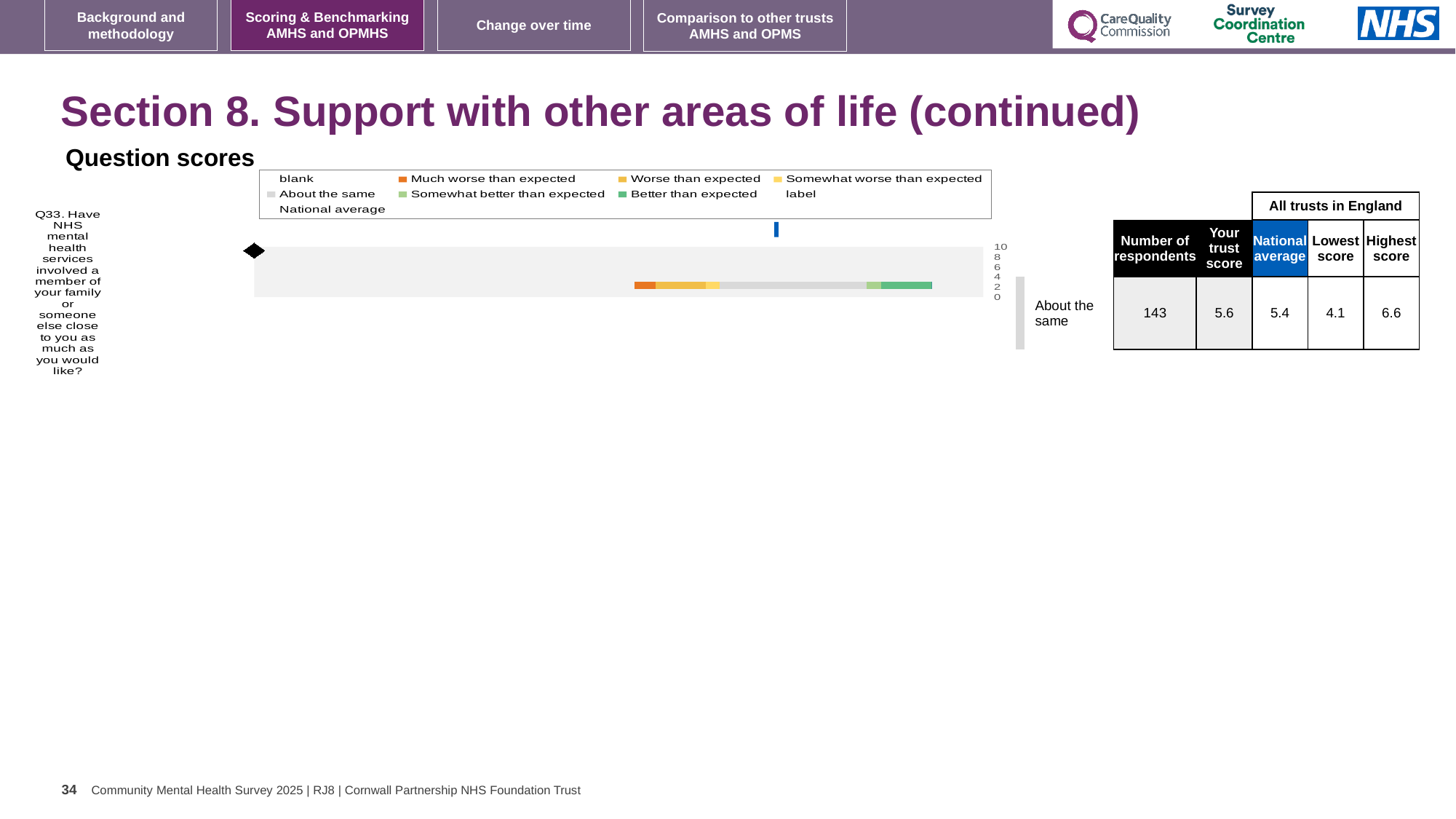
What is the trust's score for Q33? 5.6 What colour does the legend use for 'Better than expected'? green Which question is plotted in the question scores chart? Q33. Have NHS mental health services involved a member of your family or someone else close to you as much as you would like? What is the lowest score among all trusts in England for Q33? 4.1 What is the national average score for Q33? 5.4 What is the difference between the highest and lowest scores among all trusts in England for Q33? 2.5 How many survey questions are plotted in the question scores chart? 1 What is the highest score among all trusts in England for Q33? 6.6 What is the benchmark category shown for Q33 next to the chart? About the same What kind of chart is used to show the Q33 question score? bar chart Which is larger for Q33, the trust's score or the national average? the trust's score What is the number of respondents for Q33? 143